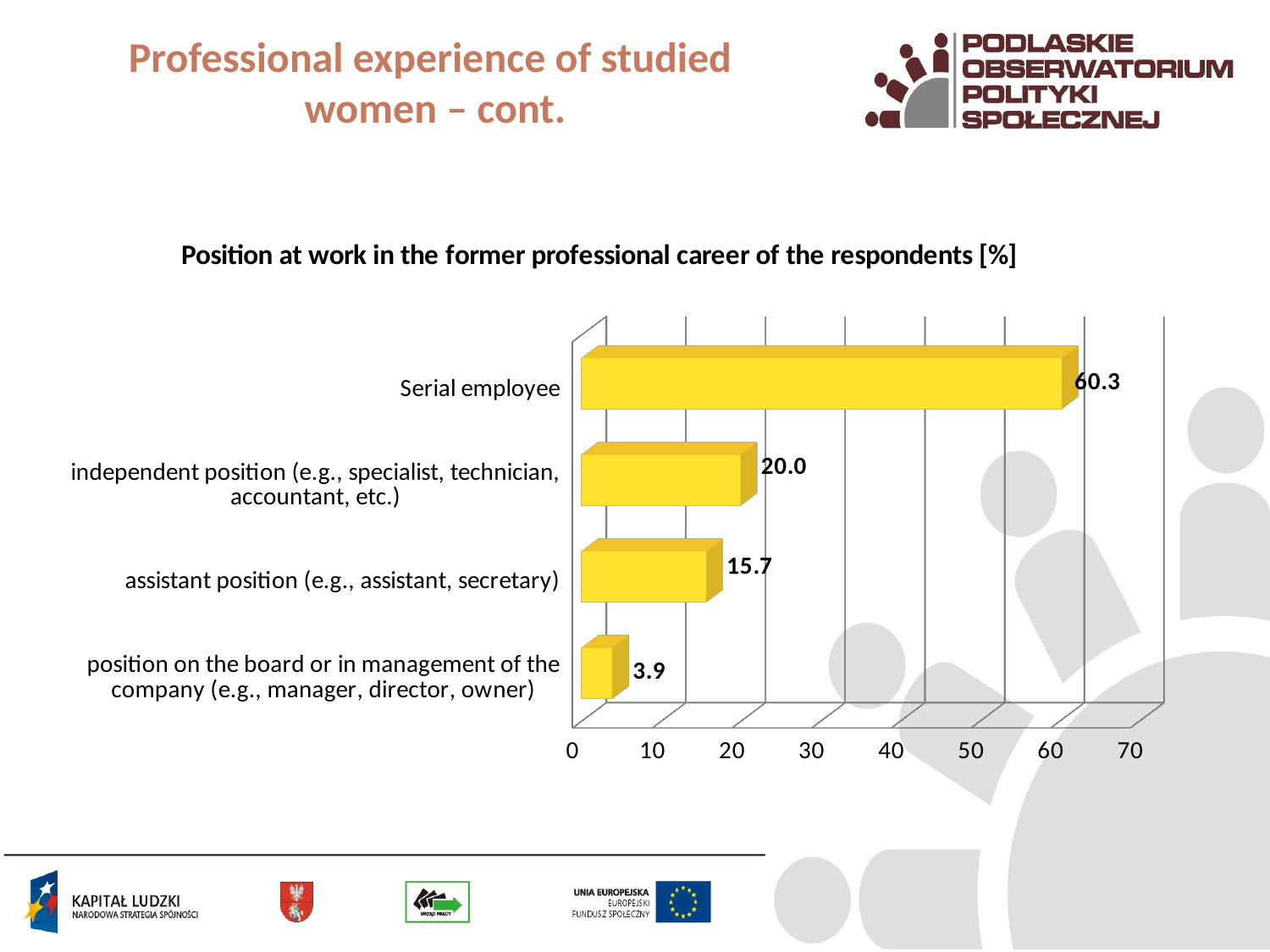
What is the title of the chart? Position at work in the former professional career of the respondents [%] Which category has the highest value? Serial employee What kind of chart is shown on the slide? bar chart What is the value for the position on the board or in management of the company category? 3.9 What is the difference between the values for Serial employee and independent position? 40.3 Which category has the lowest value? position on the board or in management of the company (e.g., manager, director, owner) Which is larger, the value for independent position or the value for assistant position? independent position What is the value for the independent position (e.g., specialist, technician, accountant, etc.) category? 20.0 What is the value for the assistant position (e.g., assistant, secretary) category? 15.7 What is the difference between the values for assistant position and position on the board or in management of the company? 11.8 How many categories are shown in the chart? 4 What is the value for Serial employee? 60.3